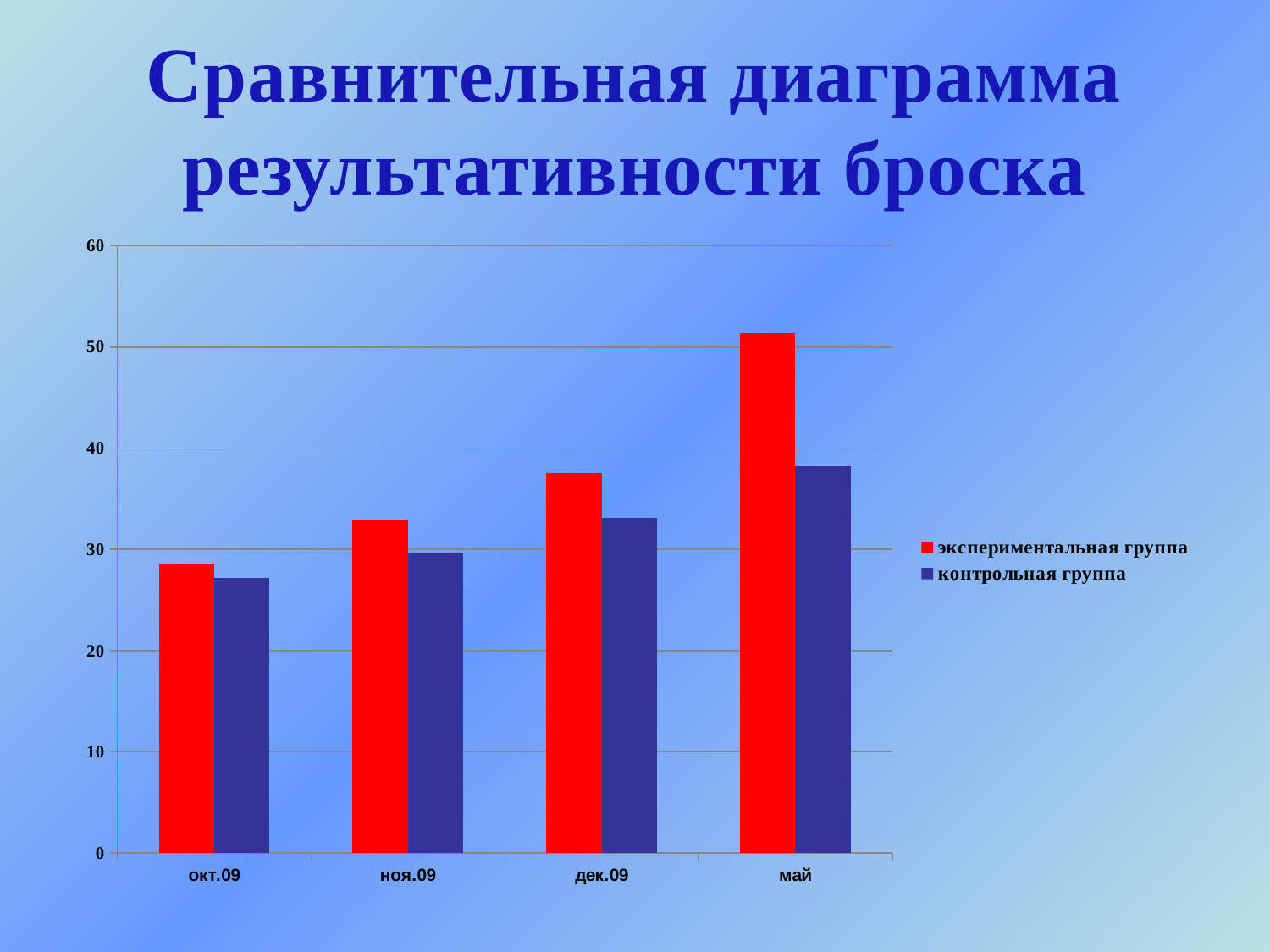
Which category has the lowest value for экспериментальная группа? окт.09 Is the value for экспериментальная группа in май greater or less than 50? greater How many series does the legend list? 2 Is the value for контрольная группа in окт.09 greater or less than 30? less Which category has the lowest value for контрольная группа? окт.09 What kind of chart is shown on the slide? bar chart In май, which series has the larger value: экспериментальная группа or контрольная группа? экспериментальная группа How many categories are shown on the x axis? 4 Which category has the highest value for экспериментальная группа? май Is the value for контрольная группа in май greater or less than 40? less What colour are the bars for контрольная группа? blue Do the values for экспериментальная группа rise or fall from окт.09 to май? rise